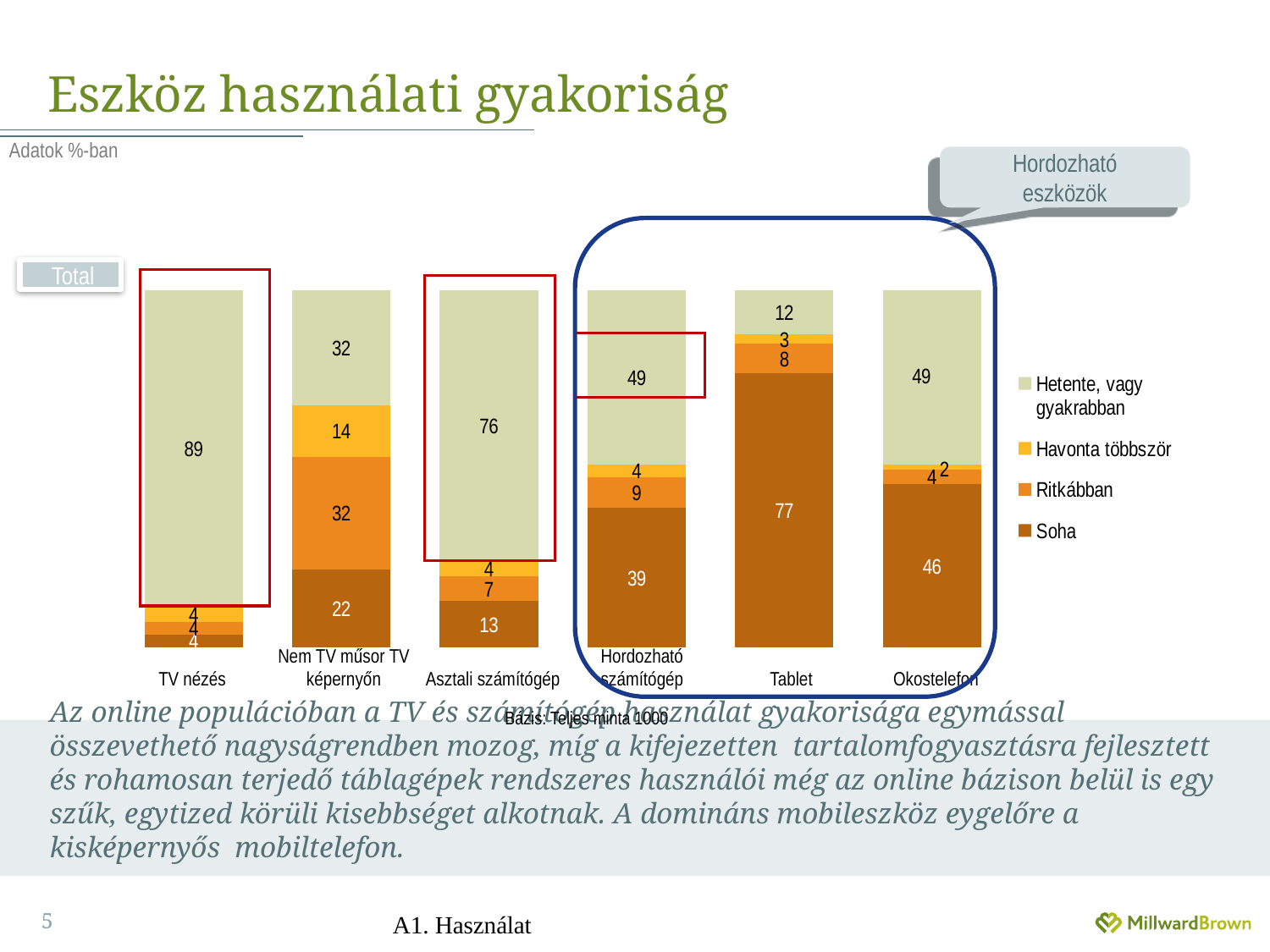
Which category has the lowest 'Hetente, vagy gyakrabban' value? Tablet What percentage of respondents use a tablet 'Soha' (never)? 77 What kind of chart is shown on the slide? Stacked bar chart How many series does the legend list? 4 Which category has the highest 'Hetente, vagy gyakrabban' value? TV nézés How many categories are shown on the x axis of the chart? 6 Which is larger: the 'Hetente, vagy gyakrabban' value for Nem TV műsor TV képernyőn or for Hordozható számítógép? Hordozható számítógép What is the 'Soha' value for Hordozható számítógép? 39 What is the total of the stacked bar for Tablet? 100 What is the 'Ritkábban' value for Nem TV műsor TV képernyőn? 32 What is the difference between the 'Soha' values for Tablet and Okostelefon? 31 What is the 'Hetente, vagy gyakrabban' value for Asztali számítógép? 76